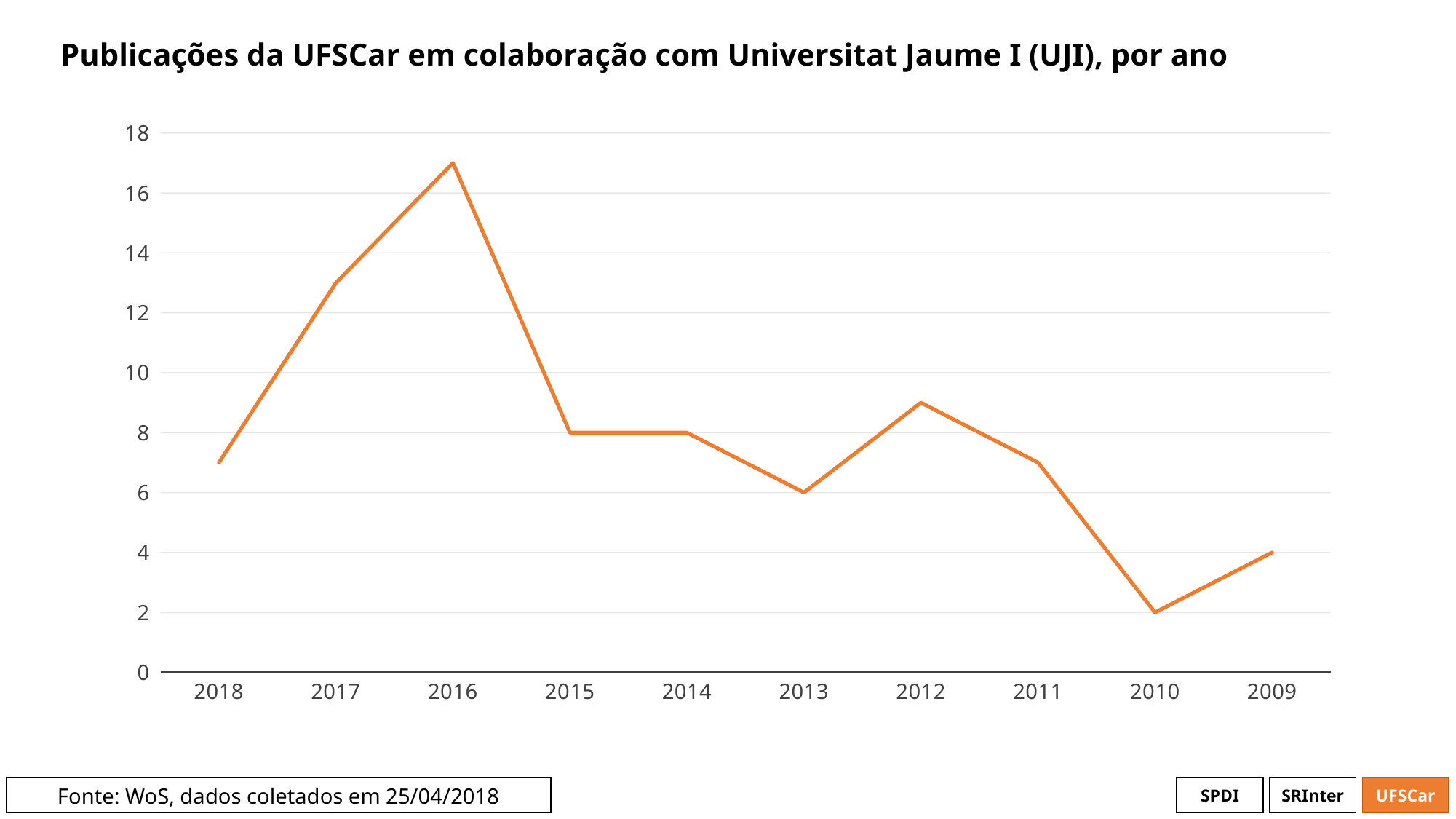
What kind of chart is shown on the slide? line chart In which year is the number of publications highest? 2016 What is the number of publications in 2015? 8 What is the number of publications in 2013? 6 How many years are plotted along the x axis? 10 Is the value for 2016 greater or less than 16? greater In which year is the number of publications lowest? 2010 Which year has more publications, 2017 or 2012? 2017 What is the number of publications in 2009? 4 What is the number of publications in 2010? 2 What is the difference between the number of publications in 2015 and in 2010? 6 Is the value for 2017 greater or less than 12? greater